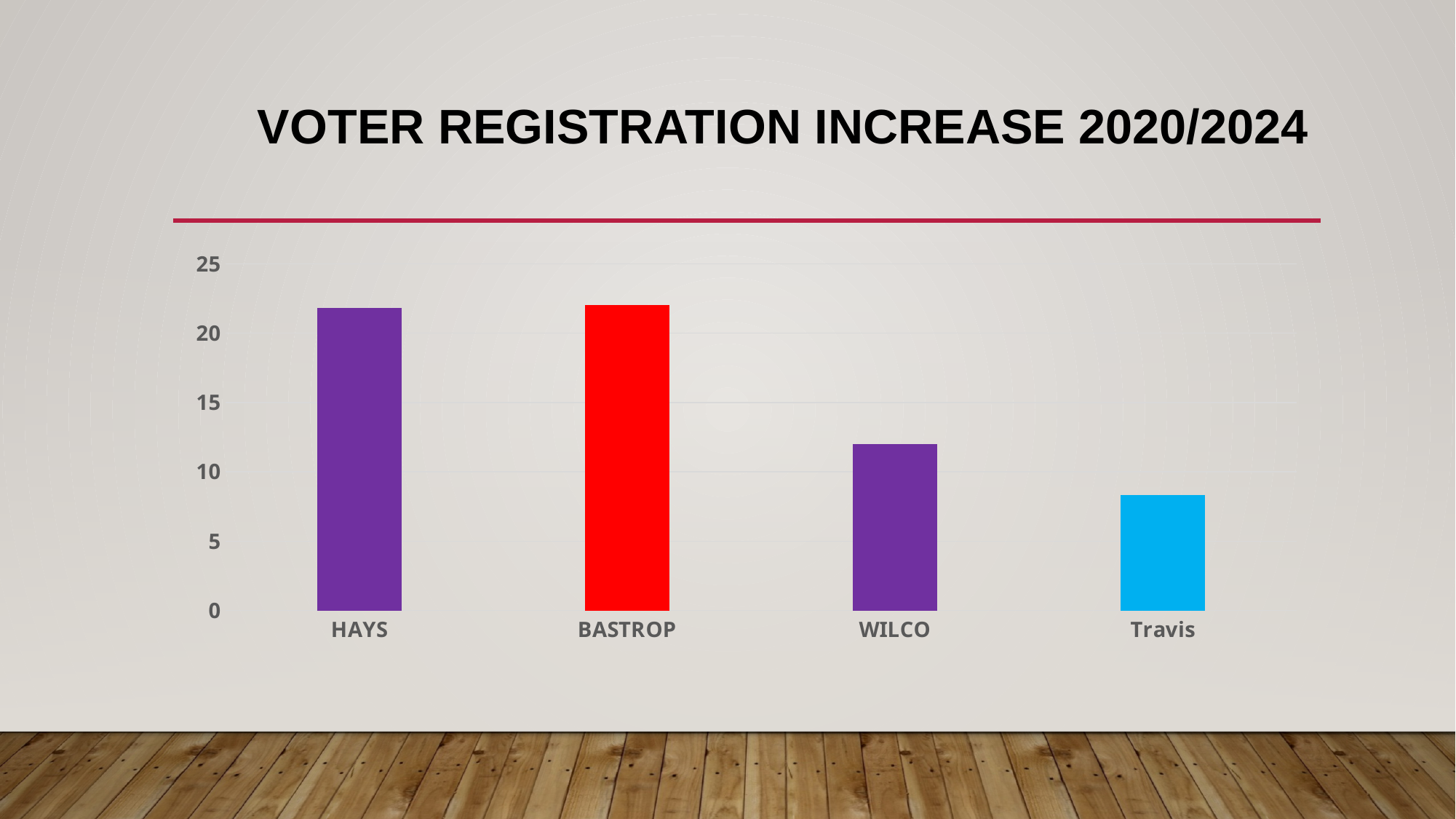
Which is larger, the value for HAYS or the value for WILCO? HAYS What kind of chart is shown on the slide? bar chart Is the value for Travis greater or less than 10? less Which is larger, the value for WILCO or the value for Travis? WILCO Is the value for HAYS greater or less than 20? greater Is the value for WILCO greater or less than 15? less What colour is the bar for BASTROP? red Which county has the lowest voter registration increase? Travis How many counties are shown on the chart? 4 What is the title of the chart? VOTER REGISTRATION INCREASE 2020/2024